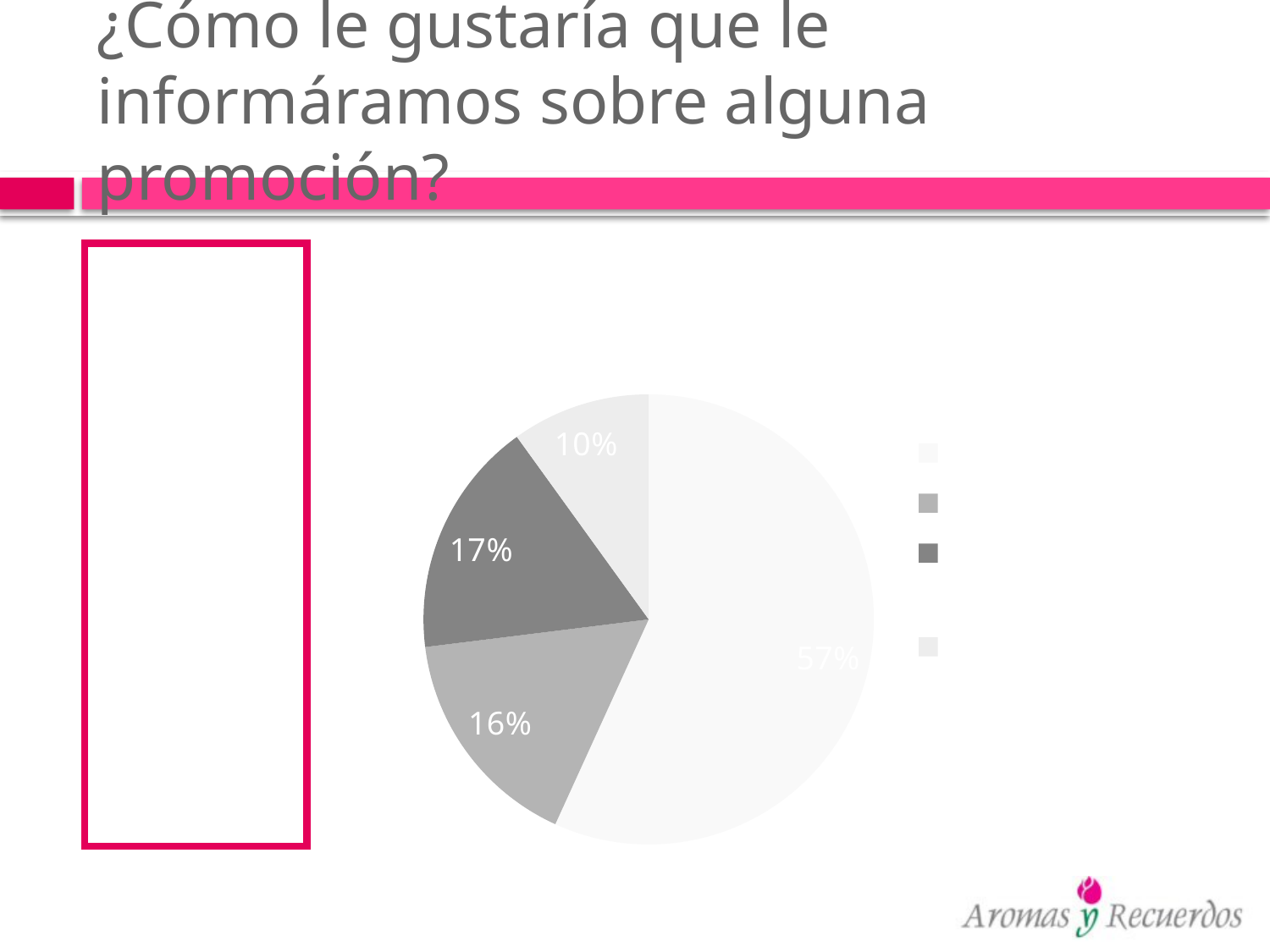
What percentage is shown on the dark grey slice of the pie chart? 17% What kind of chart is shown on the slide? pie chart How many entries does the legend of the pie chart list? 4 Is the largest slice of the pie chart greater or less than 50%? greater What is the difference in percentage points between the 17% slice and the 16% slice? 1 What percentage is shown on the medium grey slice at the lower left of the pie chart? 16% How many slices does the pie chart have? 4 What question does the slide title ask? ¿Cómo le gustaría que le informáramos sobre alguna promoción? Which slice is larger: the dark grey slice or the medium grey slice? the dark grey slice (17%) What is the value of the smallest slice in the pie chart? 10% What is the difference in percentage points between the largest slice (57%) and the smallest slice (10%)? 47 What is the value of the largest slice in the pie chart? 57%